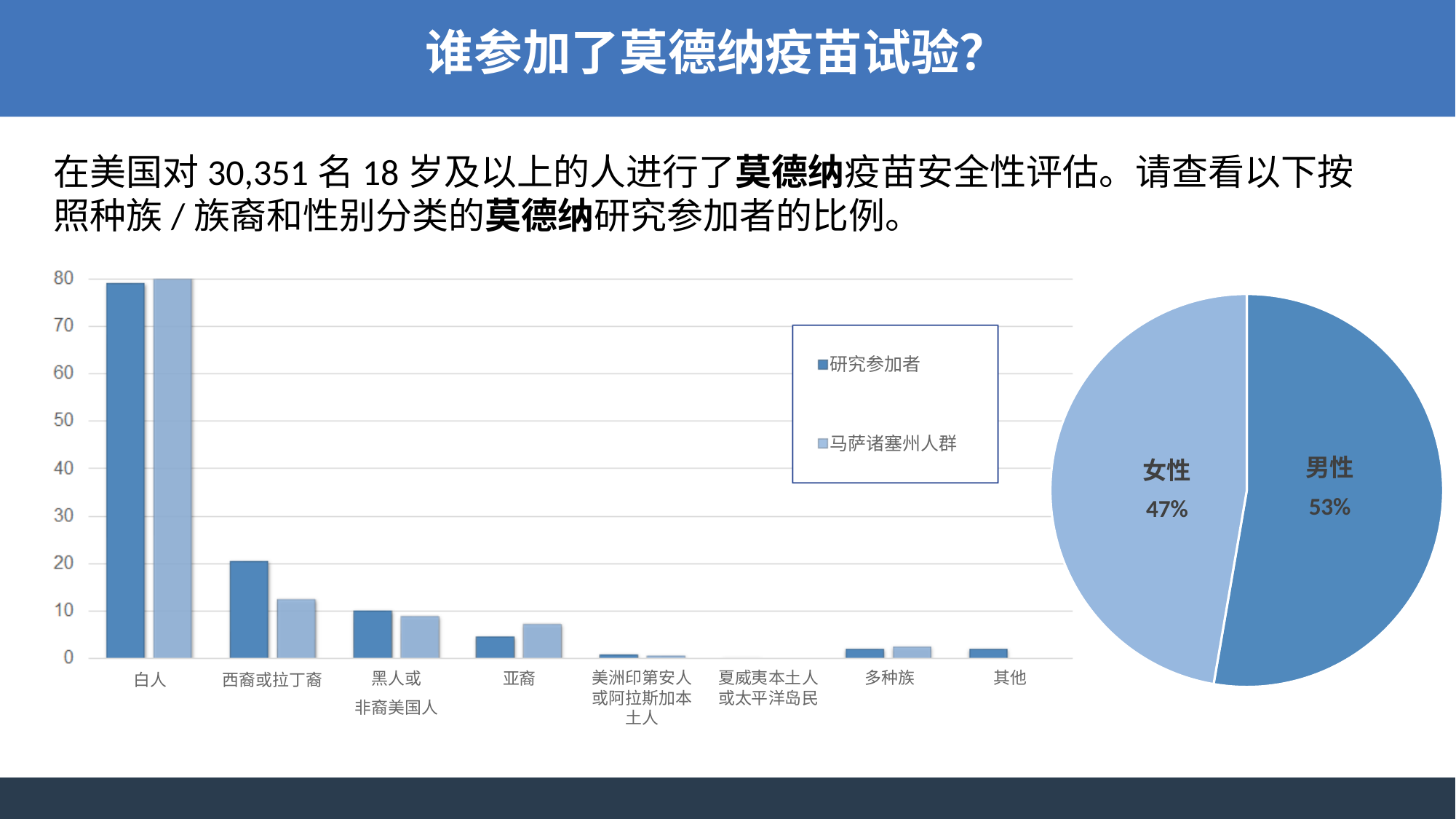
What kind of chart is the chart on the left side of the slide? bar chart In the bar chart on the left, is the 马萨诸塞州人群 value for 亚裔 greater or less than 10? less In the pie chart on the right, what is the difference between the 男性 and 女性 shares? 6% In the bar chart on the left, is the 研究参加者 value for 白人 greater or less than 70? greater In the bar chart on the left, which category has the lowest value for 研究参加者? 夏威夷本土人或太平洋岛民 In the bar chart on the left, for 亚裔, which series has the larger value: 研究参加者 or 马萨诸塞州人群? 马萨诸塞州人群 In the bar chart on the left, for 西裔或拉丁裔, which series has the larger value: 研究参加者 or 马萨诸塞州人群? 研究参加者 What kind of chart is the chart on the right side of the slide? pie chart In the bar chart on the left, how many series does the legend list? 2 In the bar chart on the left, how many categories are shown on the x axis? 8 In the pie chart on the right, what share is shown for 男性? 53% In the bar chart on the left, which category has the highest value for 研究参加者? 白人